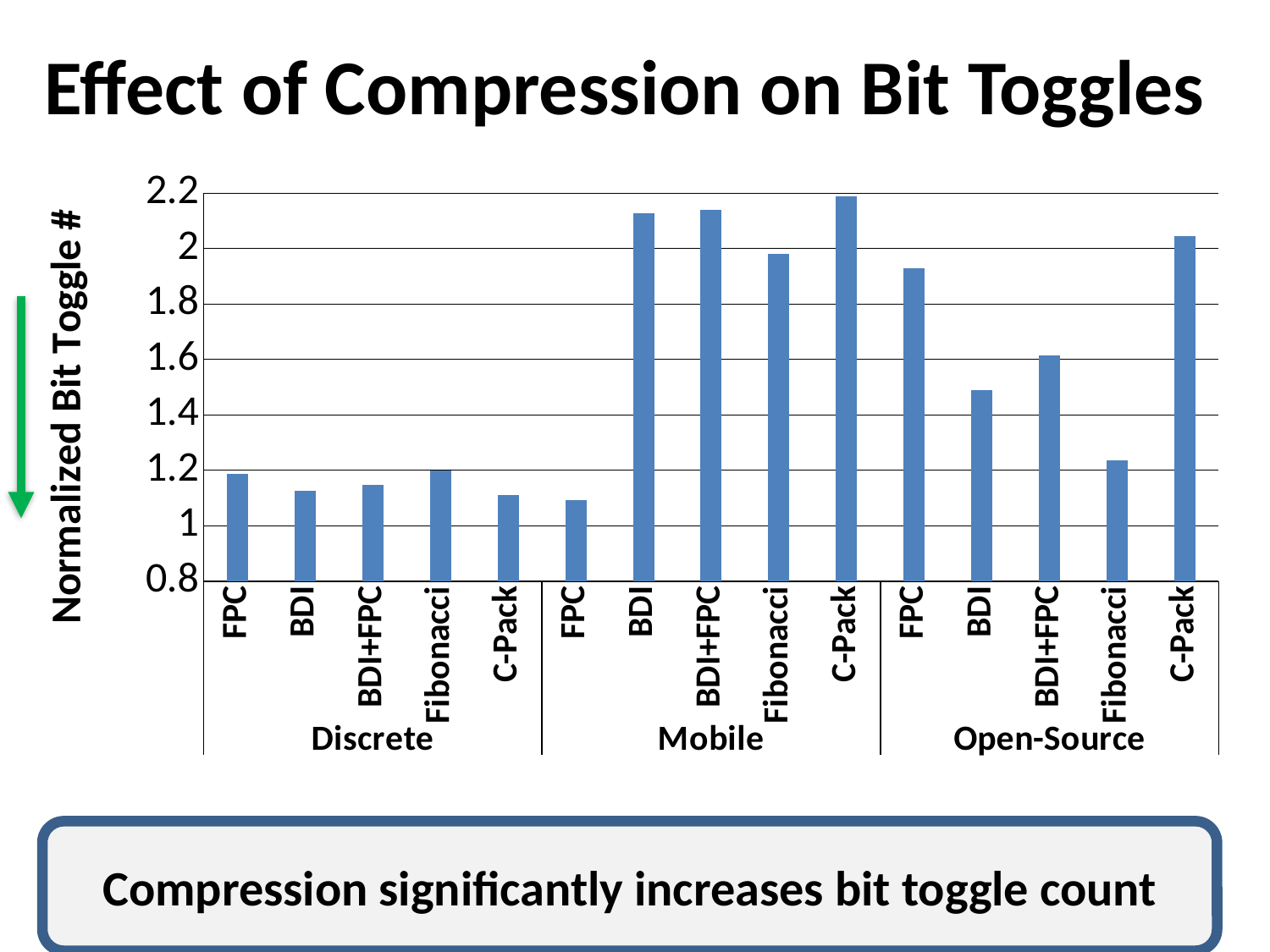
What is the title of the y axis? Normalized Bit Toggle # What kind of chart is shown on the slide? bar chart Which compression scheme has the highest value in the Open-Source group? C-Pack Is the value for BDI in the Mobile group greater or less than 2? greater Which compression scheme has the lowest value in the Mobile group? FPC How many bars are plotted in total? 15 How many application groups are shown along the x axis? 3 Is the value for FPC in the Open-Source group greater or less than 2? less Which is larger: FPC in the Discrete group or FPC in the Open-Source group? FPC in the Open-Source group Is the value for BDI in the Open-Source group greater or less than 1.6? less Which is larger: BDI in the Mobile group or BDI in the Open-Source group? BDI in the Mobile group